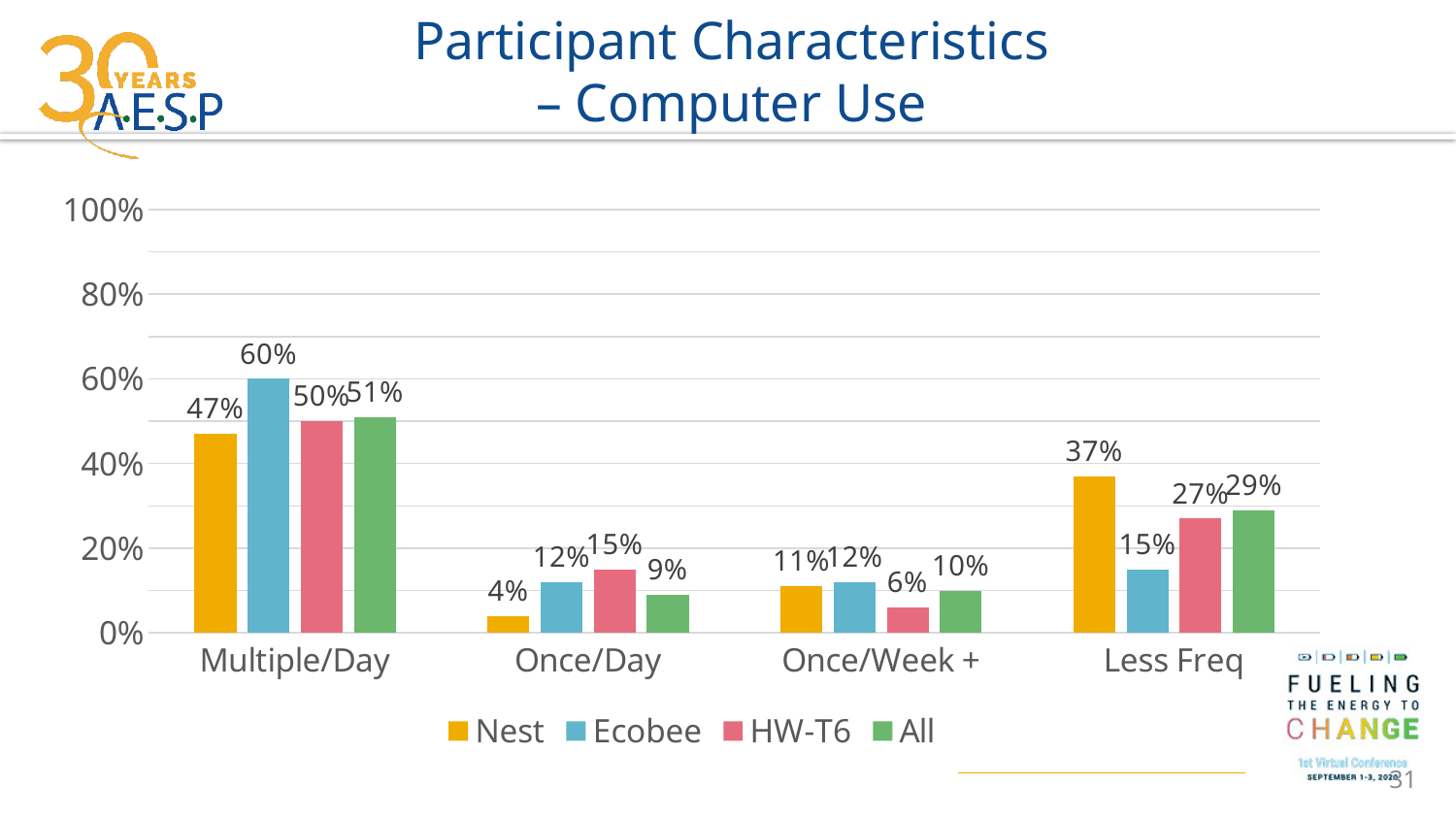
Which series has the lowest value in the Once/Day category? Nest Which series has the highest value in the Multiple/Day category? Ecobee What kind of chart is shown on the slide? Bar chart Which is larger in the Once/Day category, the HW-T6 value or the All value? HW-T6 What is the value for Ecobee in the Multiple/Day category? 60% What is the value for Nest in the Less Freq category? 37% What is the value for HW-T6 in the Once/Week + category? 6% Is the value for Nest in the Multiple/Day category greater or less than 40%? greater How many categories are shown on the x axis? 4 What is the difference between the Nest and Ecobee values in the Less Freq category? 22% What colour represents the All series in the legend? Green How many series does the legend list? 4